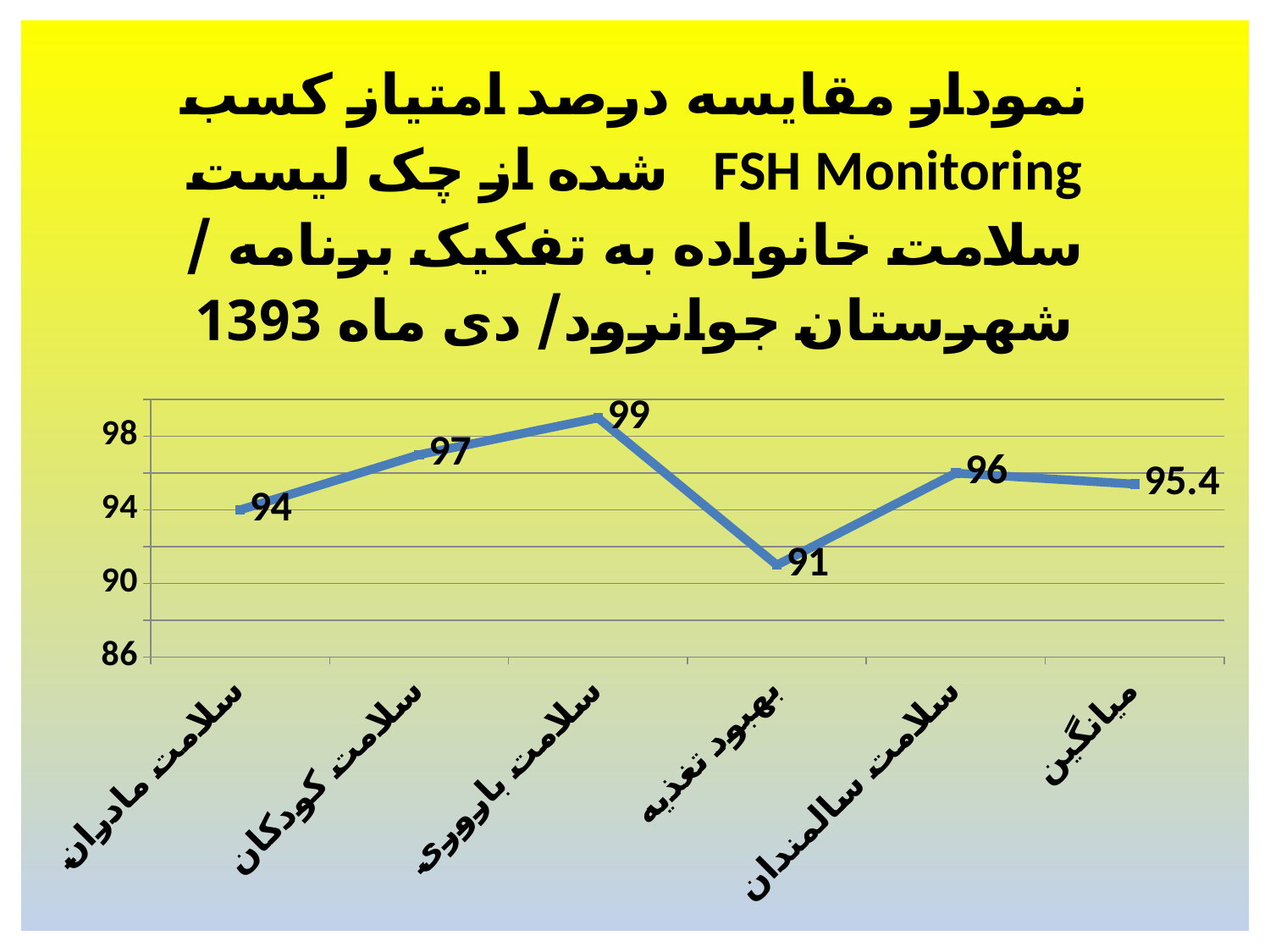
Which is larger, the value for سلامت سالمندان or the value for سلامت مادران? سلامت سالمندان What is the difference between the values for سلامت باروری and بهبود تغذیه? 8 Which category has the lowest value? بهبود تغذیه What type of chart is shown on the slide? line chart What is the value for میانگین? 95.4 How many categories are plotted on the x axis? 6 Which category has the highest value? سلامت باروری What is the value for بهبود تغذیه? 91 What is the value for سلامت کودکان? 97 Does the line rise or fall from سلامت مادران to سلامت باروری? rise Which month and year does the chart title refer to? دی ماه 1393 What is the value for سلامت مادران? 94